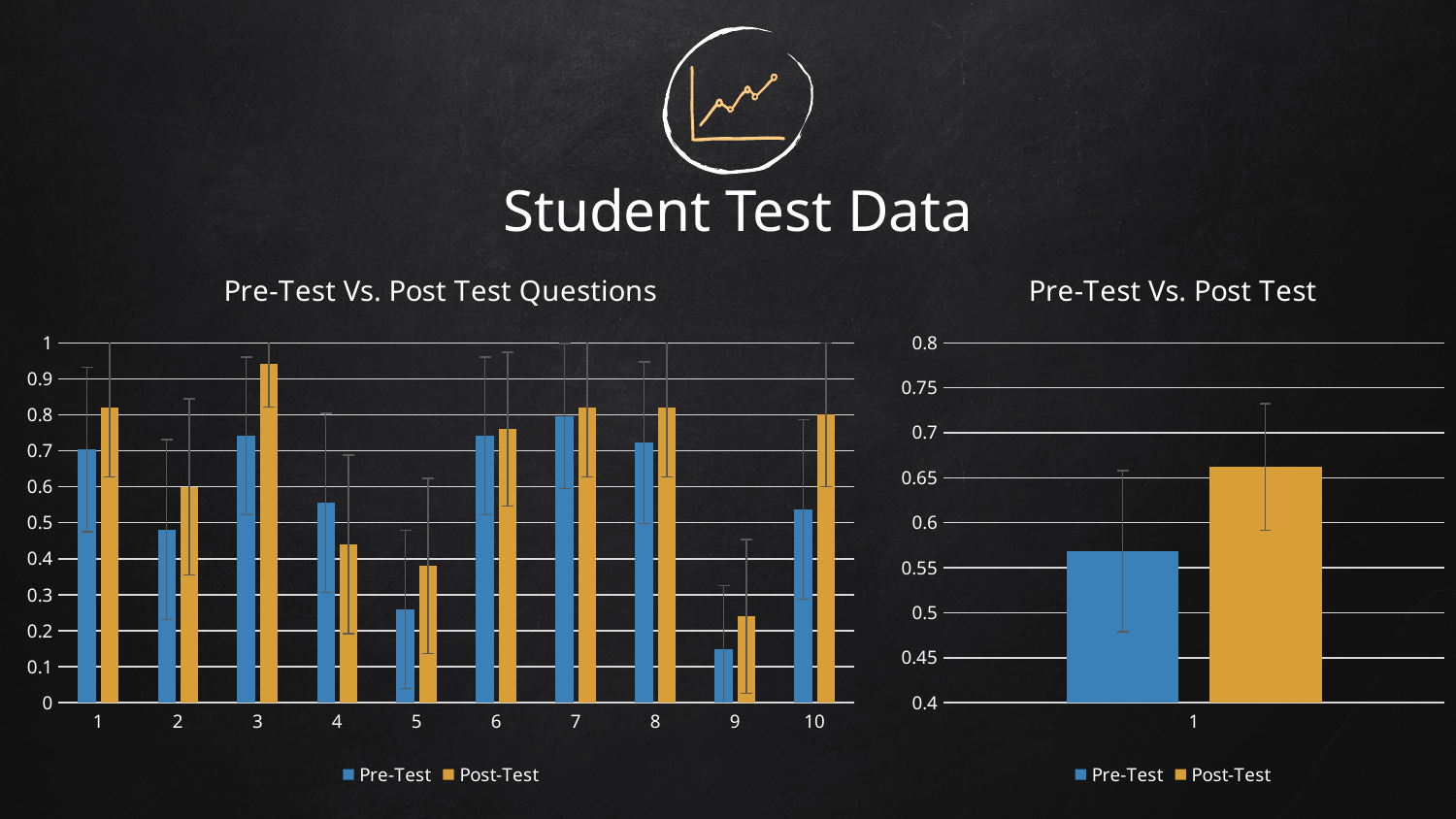
How many series does the legend of the 'Pre-Test Vs. Post Test Questions' chart list? 2 In the 'Pre-Test Vs. Post Test' chart on the right, is the Pre-Test value greater or less than 0.6? less In the 'Pre-Test Vs. Post Test Questions' chart, for question 4, which is larger: the Pre-Test or the Post-Test value? Pre-Test In the 'Pre-Test Vs. Post Test Questions' chart, which question has the lowest Pre-Test value? 9 What colour are the Post-Test bars in the 'Pre-Test Vs. Post Test' chart on the right? Orange In the 'Pre-Test Vs. Post Test Questions' chart, is the Pre-Test value for question 5 greater or less than 0.4? less In the 'Pre-Test Vs. Post Test Questions' chart, is the Post-Test value for question 3 greater or less than 0.9? greater In the 'Pre-Test Vs. Post Test' chart on the right, which is larger: the Pre-Test or the Post-Test bar? Post-Test In the 'Pre-Test Vs. Post Test Questions' chart, which question has the highest Post-Test value? 3 In the 'Pre-Test Vs. Post Test Questions' chart, which question has the lowest Post-Test value? 9 What kind of chart is the 'Pre-Test Vs. Post Test Questions' chart on the left? Bar chart How many question categories are shown on the x axis of the 'Pre-Test Vs. Post Test Questions' chart? 10